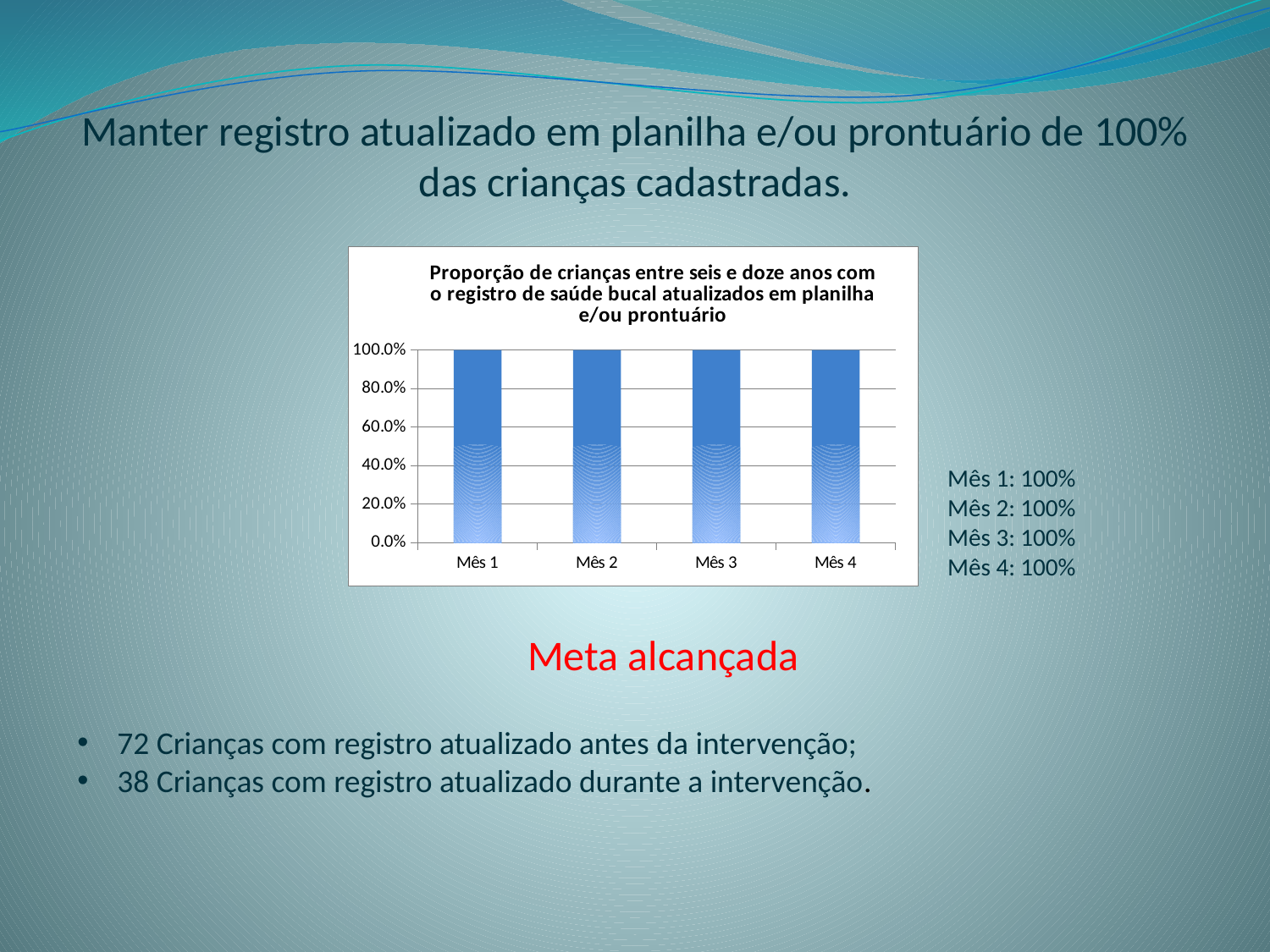
What is the value for Mês 3 in the chart? 100% How many months (categories) are shown on the x axis of the chart? 4 What is the title of the chart? Proporção de crianças entre seis e doze anos com o registro de saúde bucal atualizados em planilha e/ou prontuário What is the value for Mês 1 in the chart? 100% What is the value for Mês 4 in the chart? 100% Do the values rise, fall, or stay the same from Mês 1 to Mês 4? Stay the same What is the difference between the values for Mês 1 and Mês 4? 0% What kind of chart is shown on the slide? Bar chart Is the value for Mês 2 greater or less than 80.0%? greater What is the highest value shown on the y axis of the chart? 100.0%